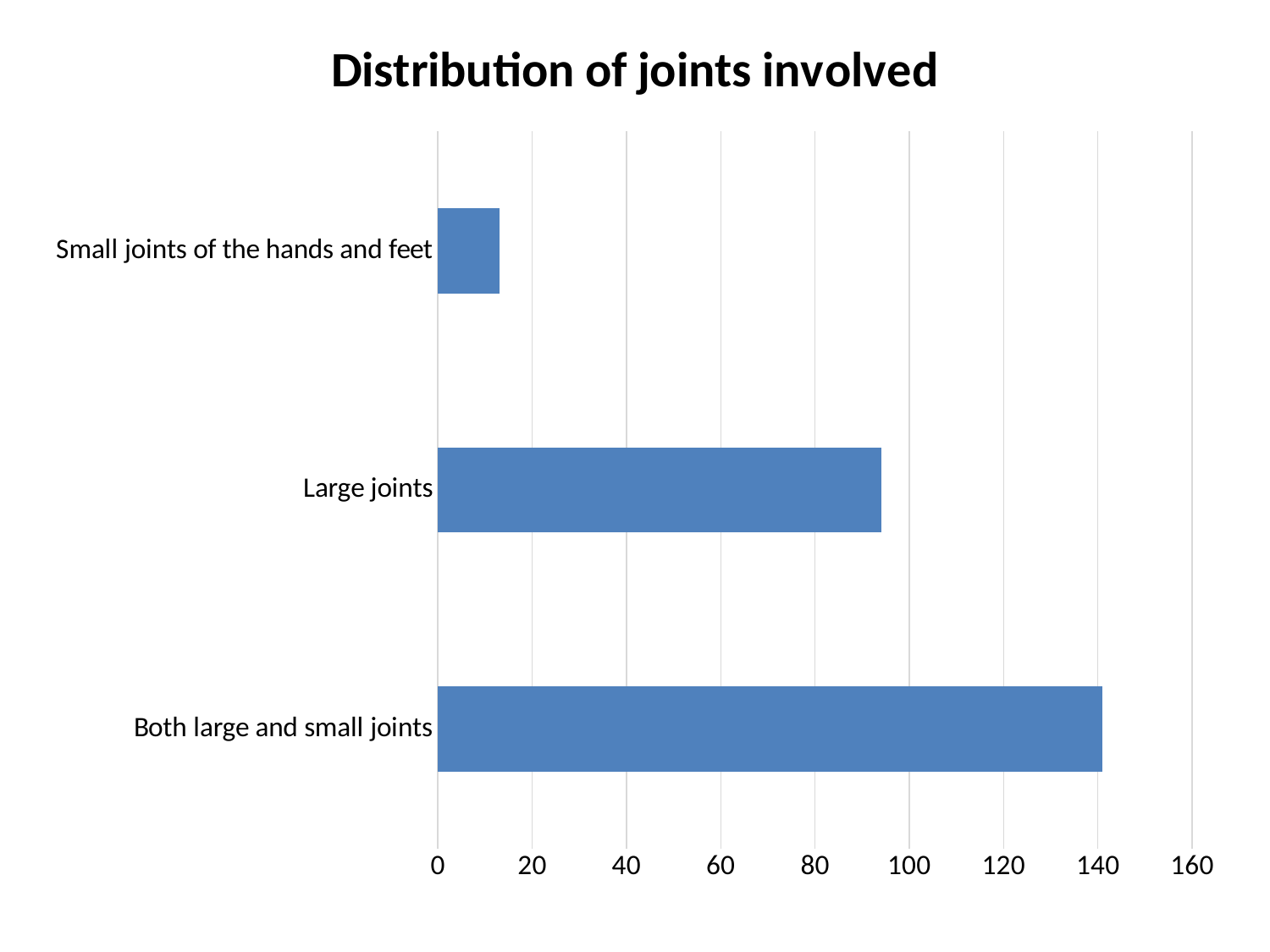
How many categories are plotted in the chart? 3 Is the value for Small joints of the hands and feet greater or less than 20? less Is the value for Both large and small joints greater or less than 120? greater What kind of chart is shown on the slide? bar chart Is the value for Large joints greater or less than 80? greater Which category has the highest value? Both large and small joints Which is larger, the value for Both large and small joints or the value for Large joints? Both large and small joints Which category has the lowest value? Small joints of the hands and feet Which is larger, the value for Large joints or the value for Small joints of the hands and feet? Large joints What is the title of the chart? Distribution of joints involved What is the highest value shown on the horizontal axis? 160